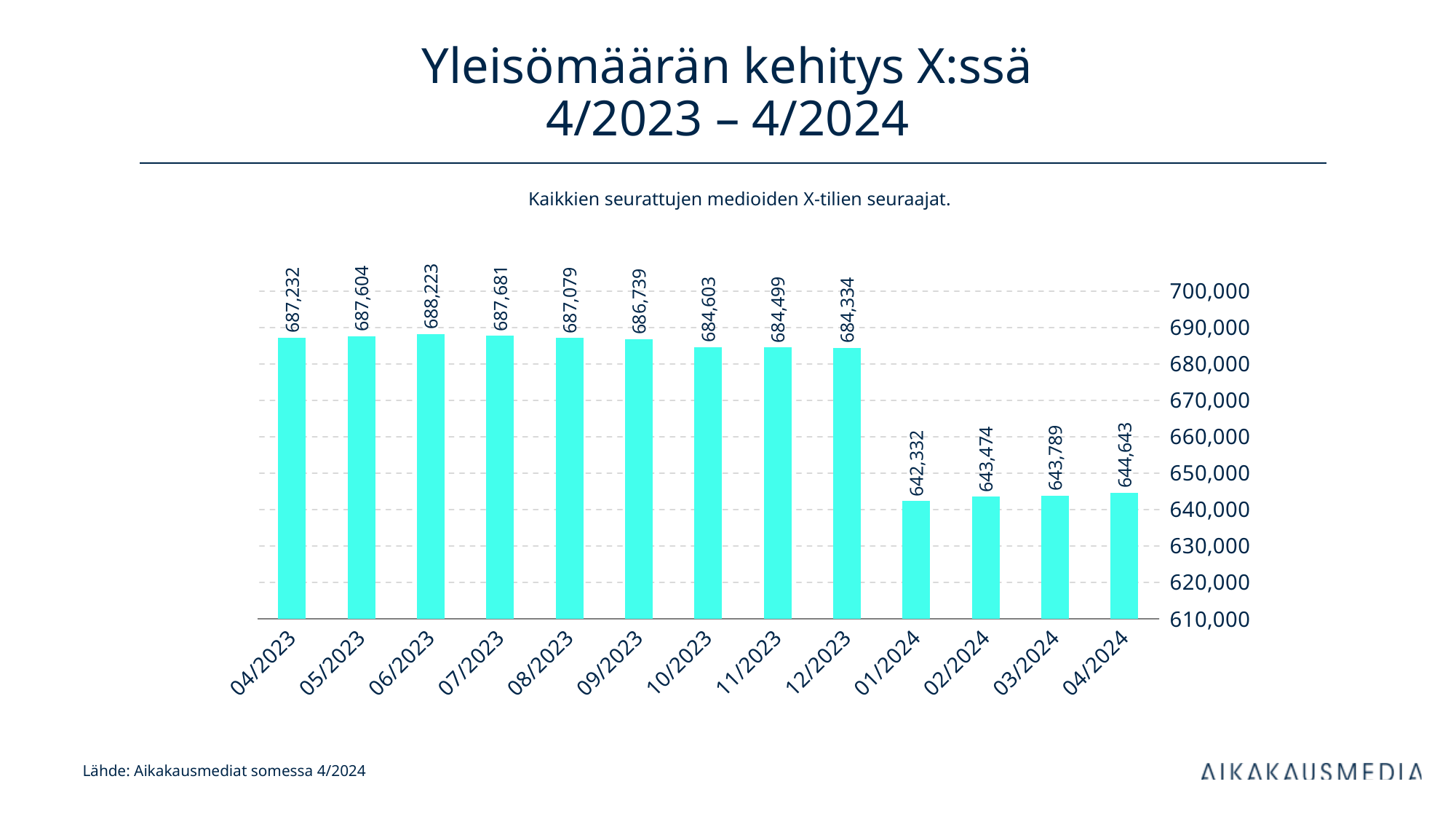
What is the difference between the values for 12/2023 and 01/2024? 42,002 What is the title of the chart on the slide? Yleisömäärän kehitys X:ssä 4/2023 – 4/2024 What is the value for 06/2023? 688,223 Is the value for 02/2024 greater or less than 650,000? less Which month has the highest value? 06/2023 What is the difference between the values for 04/2023 and 04/2024? 42,589 What is the value for 04/2024? 644,643 Which month has the lowest value? 01/2024 What is the value for 01/2024? 642,332 Which is larger, the value for 09/2023 or the value for 10/2023? 09/2023 How many months are shown on the x axis? 13 What kind of chart is shown on the slide? bar chart